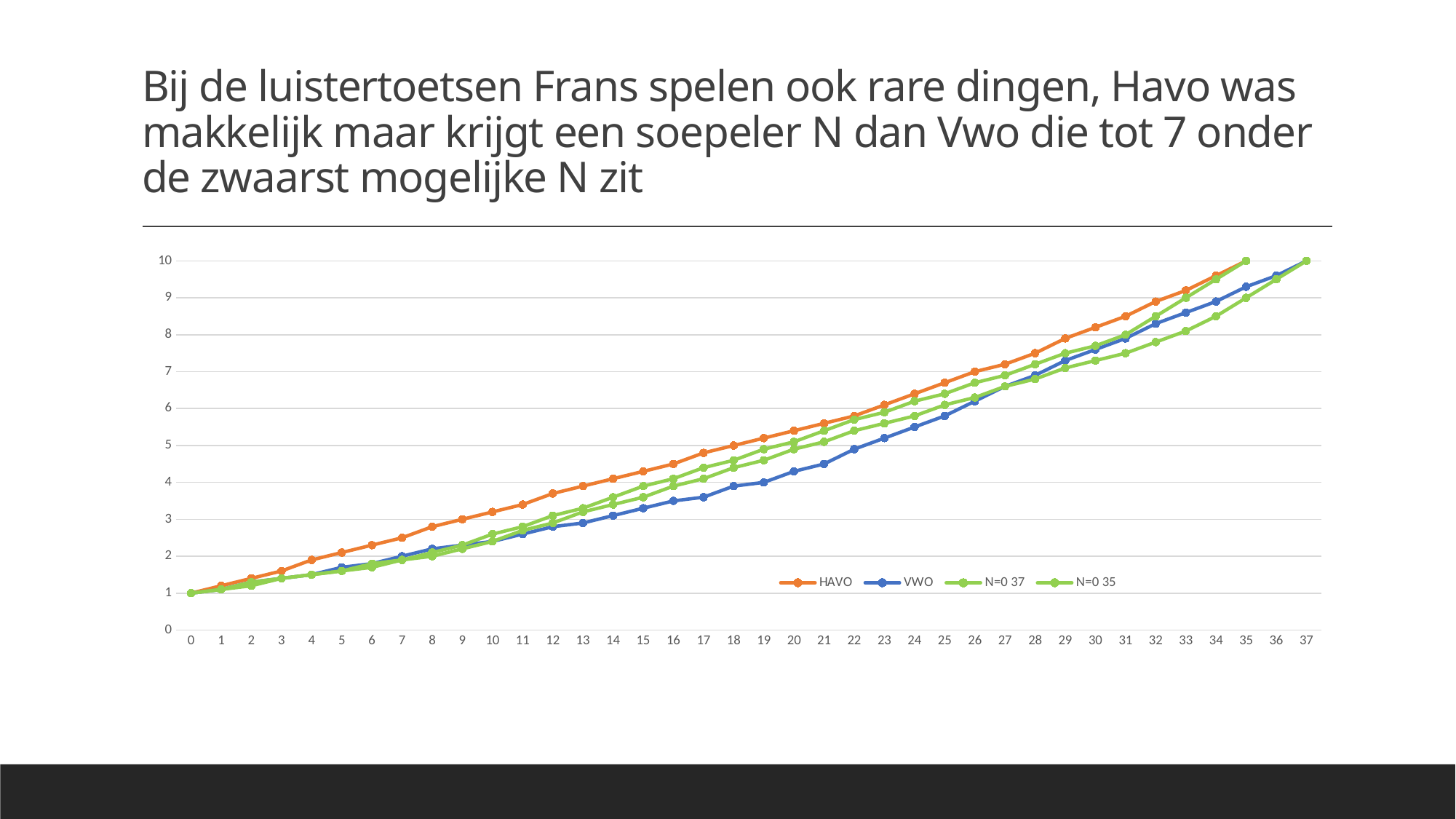
What is the value of the VWO series at x = 37? 10 At x = 15, which is larger: the HAVO value or the VWO value? HAVO How many series does the legend list? 4 Is the value of the VWO series at x = 30 greater or less than 8? less How many points are labelled on the x axis? 38 What kind of chart is shown on the slide? line chart Do the values of the series rise or fall as x increases? rise What is the value of the HAVO series at x = 35? 10 Is the value of the HAVO series at x = 20 greater or less than 5? greater Is the value of the VWO series at x = 20 greater or less than 5? less What is the value of the HAVO series at x = 0? 1 Which series are listed in the legend? HAVO, VWO, N=0 37, N=0 35